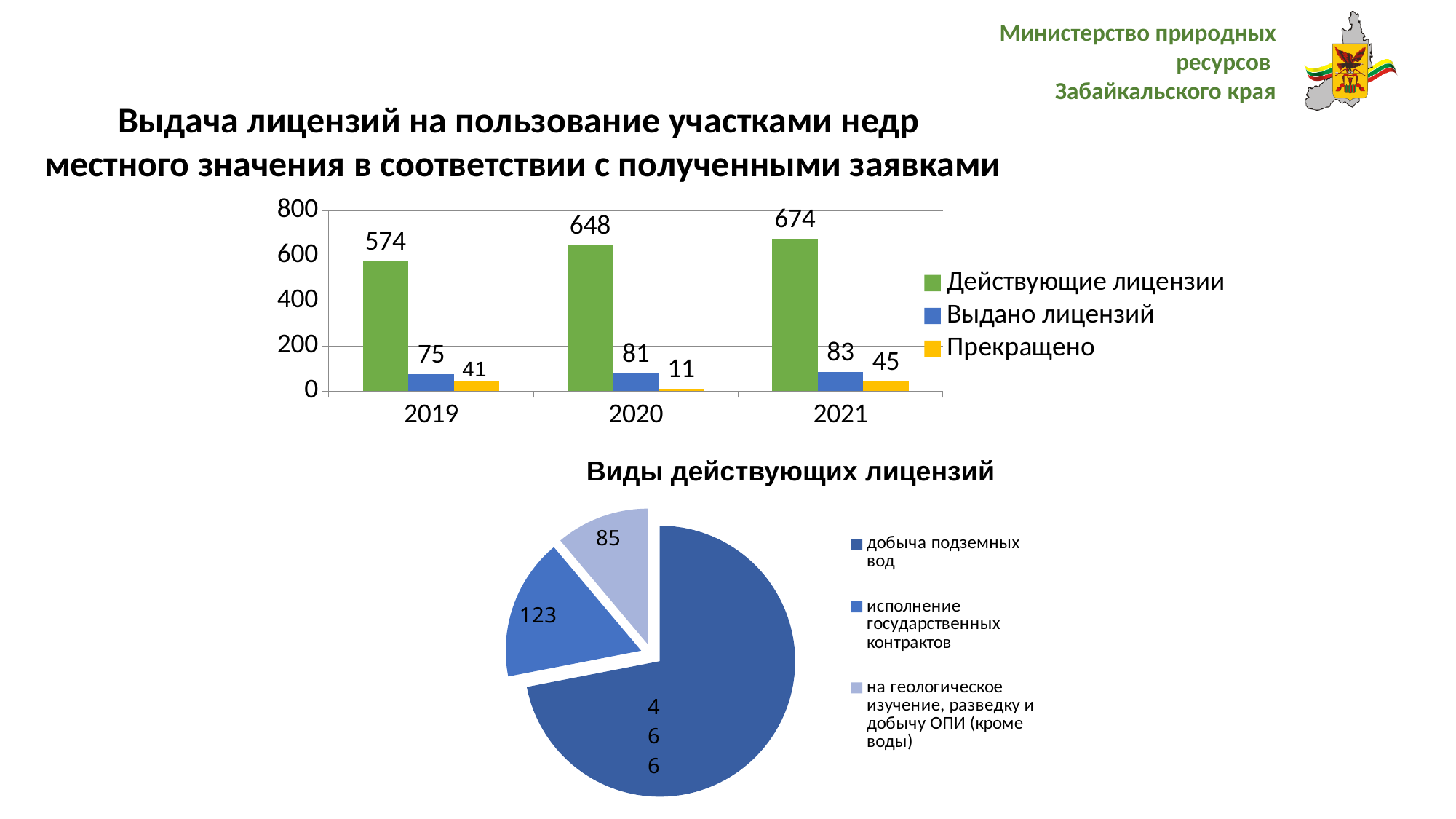
In the top bar chart, what is the difference between Действующие лицензии in 2020 and in 2019? 74 In the pie chart Виды действующих лицензий, how many slices are there? 3 In the pie chart Виды действующих лицензий, which category has the largest slice? добыча подземных вод In the top bar chart, what is the value of Выдано лицензий for 2019? 75 How many series does the legend of the top bar chart list? 3 In the top bar chart, which year has the highest value for Действующие лицензии? 2021 In the pie chart Виды действующих лицензий, what is the value for исполнение государственных контрактов? 123 In the top bar chart, does Действующие лицензии rise or fall from 2019 to 2021? rise In the top bar chart, which year has the lowest value for Прекращено? 2020 In the top bar chart, what is the value of Прекращено for 2020? 11 What kind of chart is the chart titled Виды действующих лицензий? pie chart In the top bar chart, what is the value of Действующие лицензии for 2021? 674